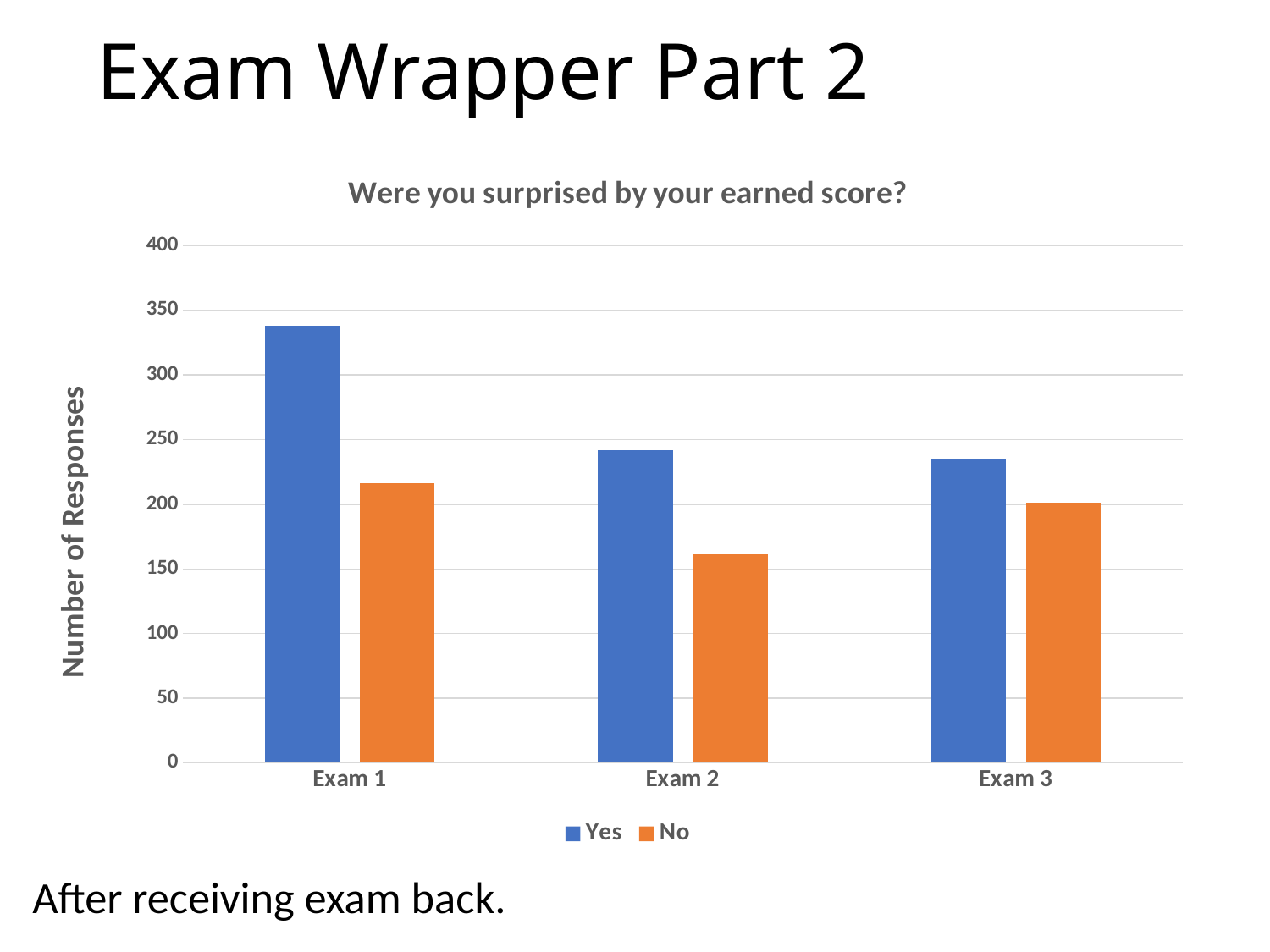
How many series does the legend list? 2 Is the Yes value for Exam 3 greater or less than 250? less For Exam 2, which is larger, the Yes bar or the No bar? Yes Does the Yes series rise or fall from Exam 1 to Exam 2? fall For which exam is the No bar the lowest? Exam 2 Is the No value for Exam 2 greater or less than 150? greater For which exam is the Yes bar the highest? Exam 1 What is the label on the vertical axis? Number of Responses How many exam categories are shown on the x axis? 3 Is the Yes value for Exam 1 greater or less than 300? greater What kind of chart is shown on the slide? bar chart What is the title of the chart? Were you surprised by your earned score?